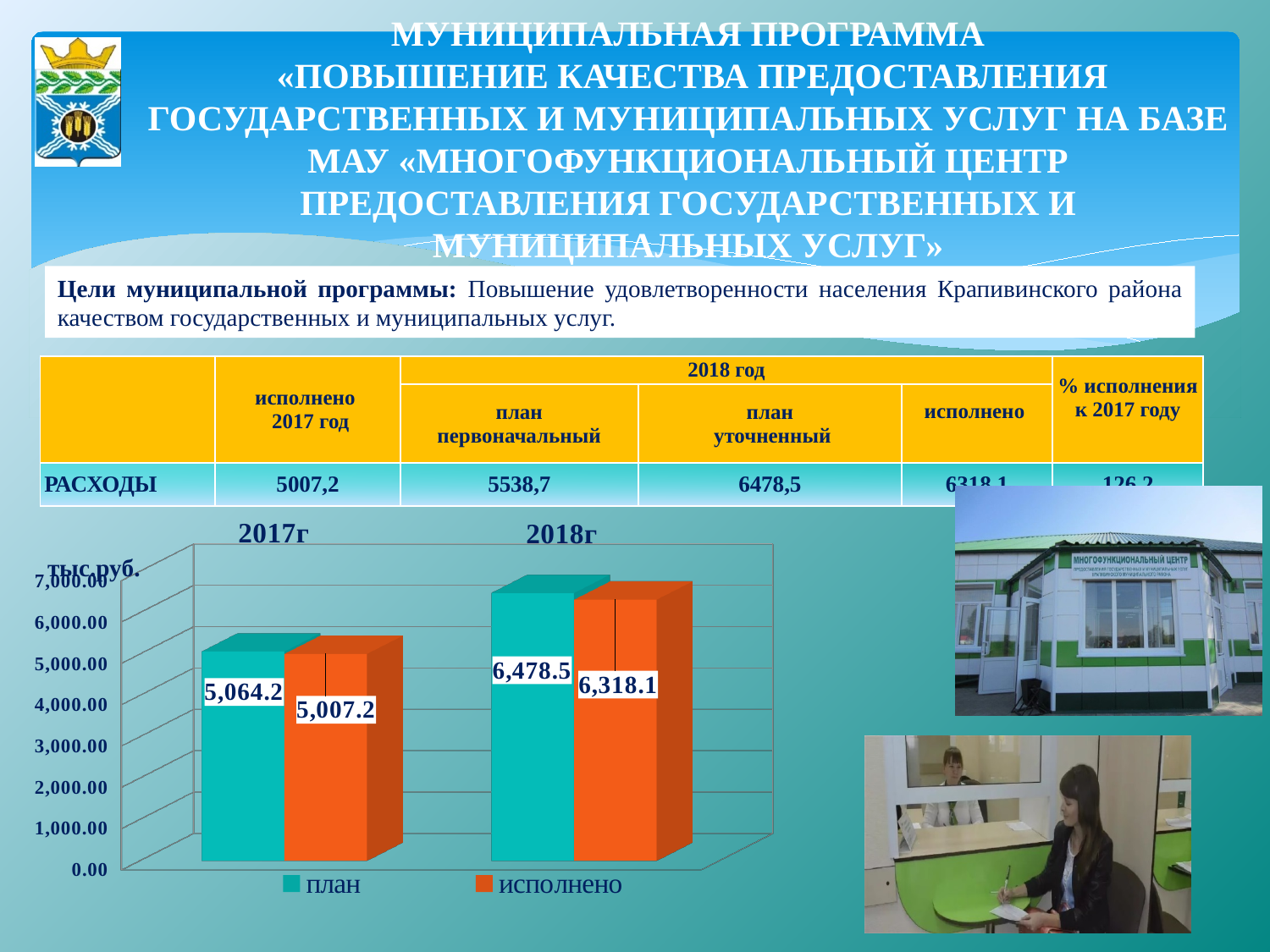
Which is larger for 2017г, план or исполнено? план How many series does the chart legend list? 2 Which bar in the chart has the highest value? план for 2018г Which bar in the chart has the lowest value? исполнено for 2017г What is the difference between план and исполнено for 2018г? 160.4 What is the value of план for 2018г? 6,478.5 What is the value of исполнено for 2017г? 5,007.2 What is the value of план for 2017г? 5,064.2 Does the исполнено value rise or fall from 2017г to 2018г? rise What kind of chart is shown on the slide? bar chart Is the value of исполнено for 2018г greater or less than 6,000.00? greater What is the value of исполнено for 2018г? 6,318.1